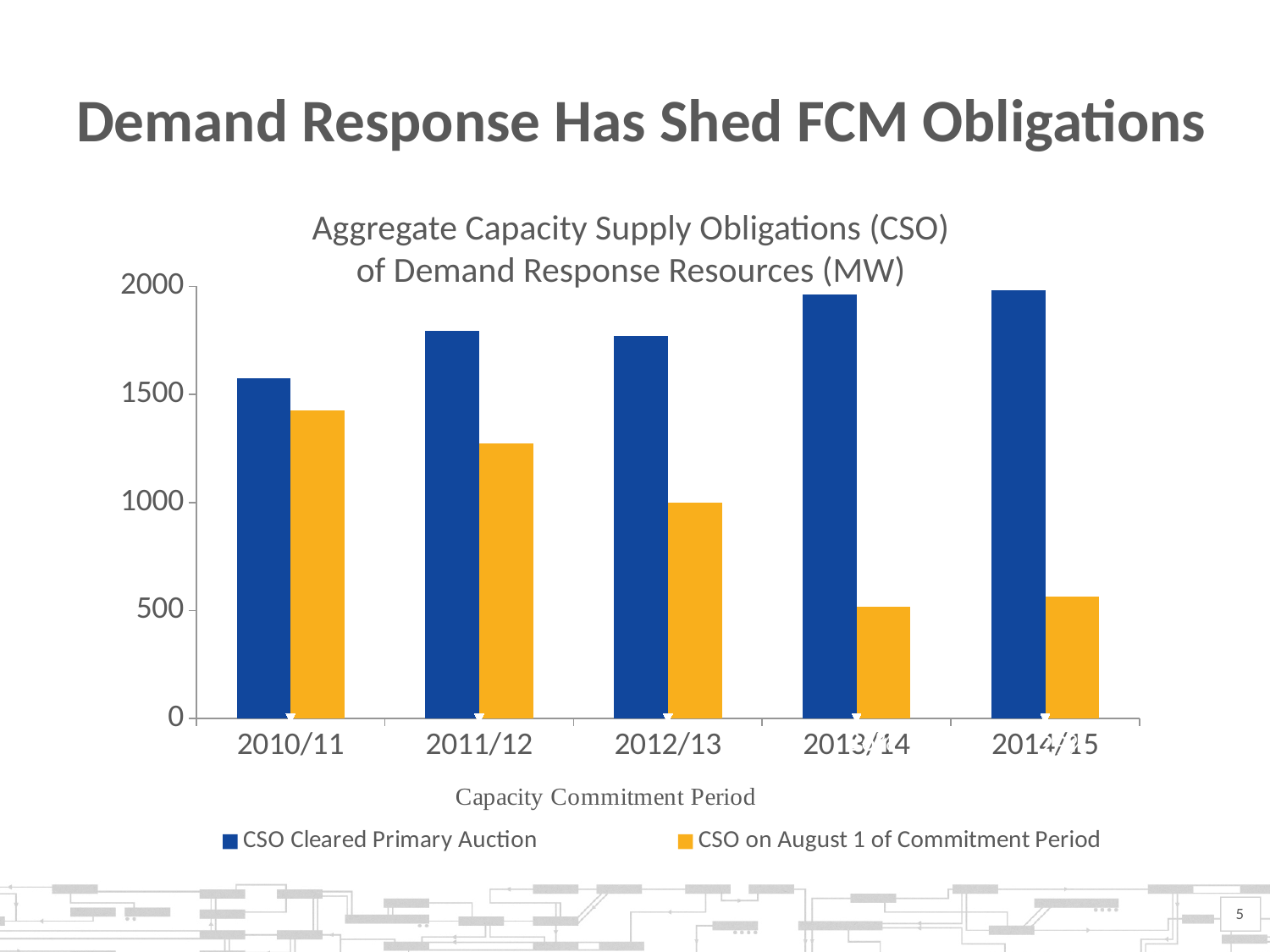
Is the CSO Cleared Primary Auction value for 2010/11 greater or less than 1500? greater Which capacity commitment period has the lowest CSO Cleared Primary Auction value? 2010/11 Is the CSO on August 1 of Commitment Period value for 2011/12 greater or less than 1000? greater How many series does the legend list? 2 Is the CSO Cleared Primary Auction value for 2013/14 greater or less than 2000? less What is the x-axis title of the chart? Capacity Commitment Period For 2012/13, which is larger: CSO Cleared Primary Auction or CSO on August 1 of Commitment Period? CSO Cleared Primary Auction What kind of chart is shown on the slide? bar chart Which is larger: the CSO on August 1 of Commitment Period value for 2010/11 or for 2012/13? 2010/11 How many capacity commitment periods are shown on the x axis? 5 Which capacity commitment period has the highest CSO on August 1 of Commitment Period value? 2010/11